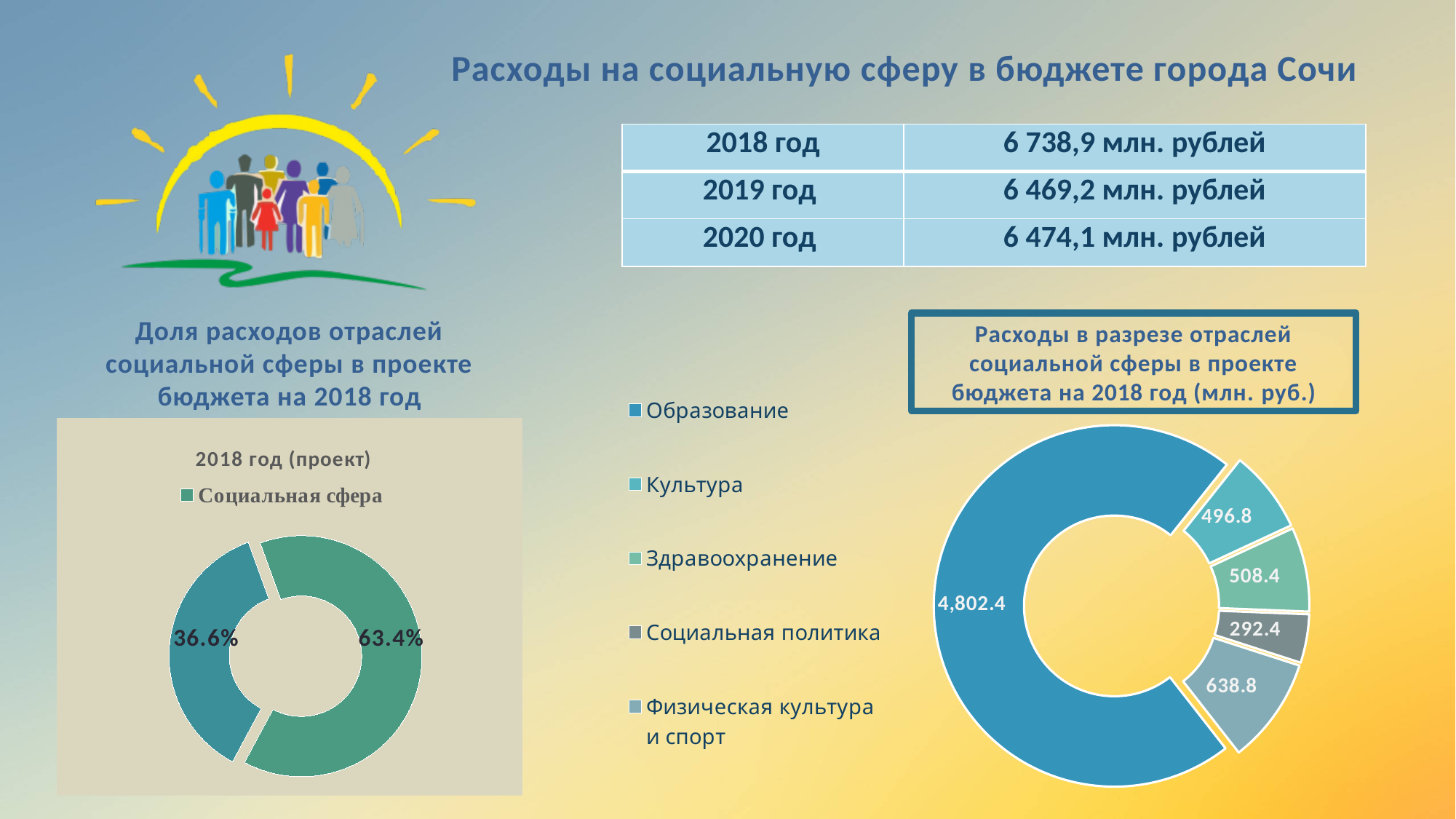
In the right donut chart, which category has the highest value? Образование In the right donut chart (Расходы в разрезе отраслей социальной сферы), what is the value for Образование? 4,802.4 How many categories does the legend of the right donut chart list? 5 In the left chart titled 2018 год (проект), what is the difference between the two slice percentages? 26.8% In the right donut chart, what is the value for Физическая культура и спорт? 638.8 What type of chart is the left chart titled 2018 год (проект)? Donut (pie) chart In the right donut chart, what is the difference between Образование and Физическая культура и спорт? 4,163.6 In the right donut chart, what is the difference between Здравоохранение and Культура? 11.6 In the right donut chart, which category has the lowest value? Социальная политика In the right donut chart, which is larger: Физическая культура и спорт or Здравоохранение? Физическая культура и спорт In the left chart titled 2018 год (проект), what share is labelled for the larger (green) slice? 63.4% In the right donut chart, what is the value for Социальная политика? 292.4